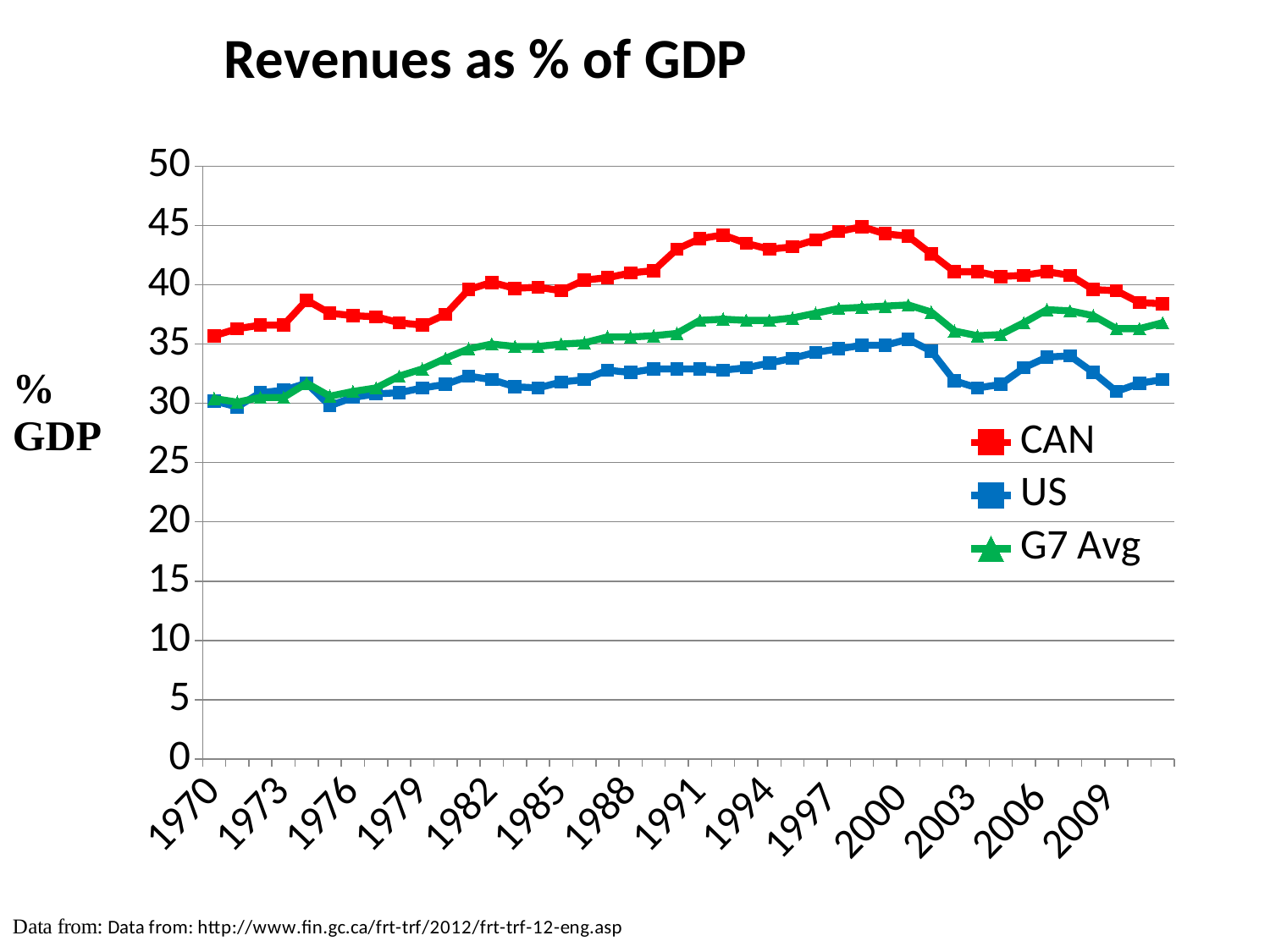
Is the value for G7 Avg in 2000 greater or less than 35? greater Is the value for US in 2009 greater or less than 35? less Does the CAN series rise or fall between 2000 and 2009? fall What is the title of the chart? Revenues as % of GDP Is the value for CAN in 1999 greater or less than 40? greater What kind of chart is shown on the slide? line chart Which series is shown in red in the legend? CAN How many series does the legend list? 3 Which series has the lowest value in 1994? US In 1985, which is larger, the value for CAN or the value for US? CAN Which series has the highest values across the whole period? CAN